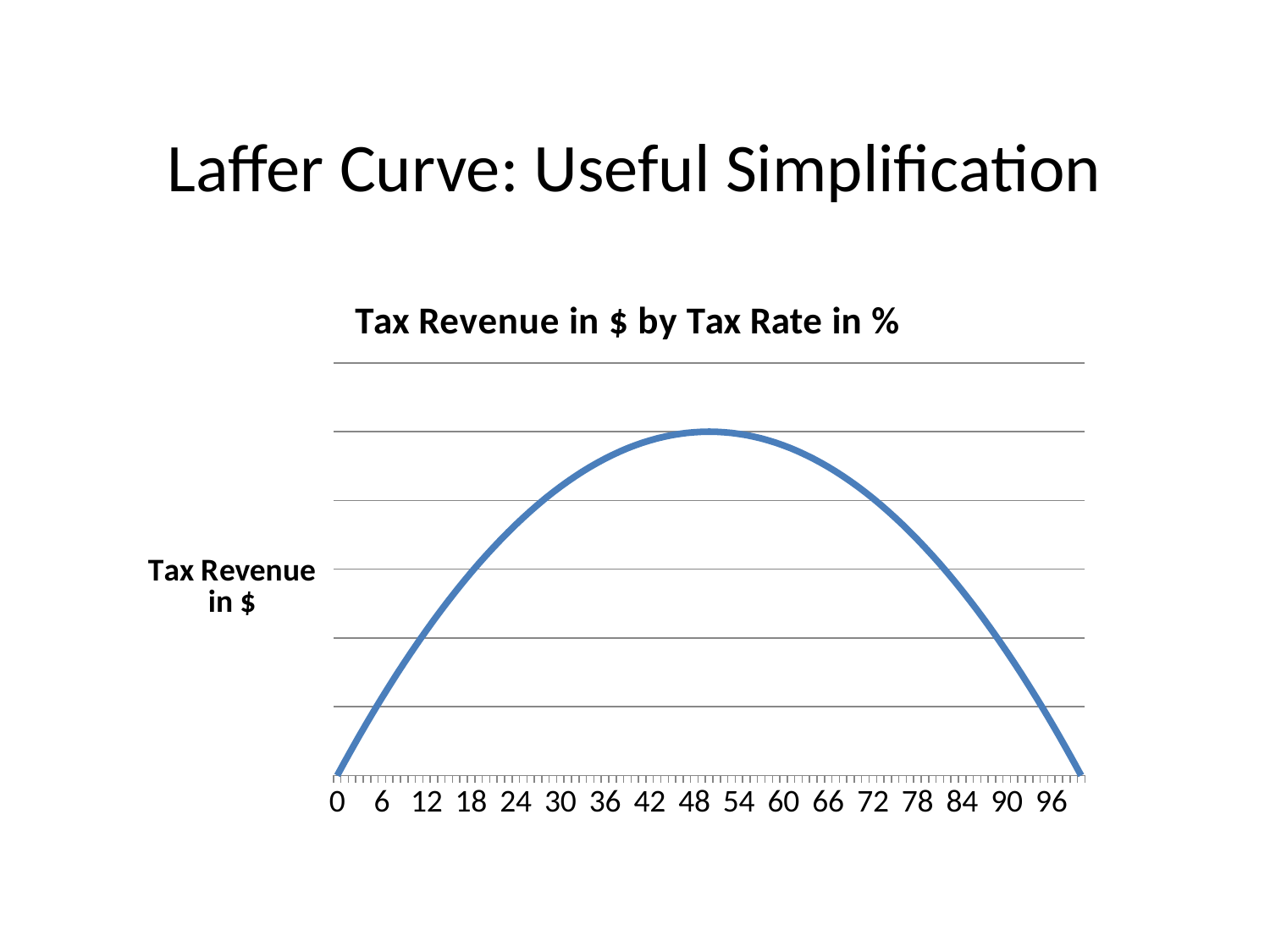
How many tick labels are printed along the x axis of the chart? 17 What is the first tick label on the x axis of the chart? 0 Which tax rate gives higher tax revenue, 12 or 48? 48 Between a tax rate of 0 and a tax rate of 48, does tax revenue rise or fall? Rise What is the title of the chart? Tax Revenue in $ by Tax Rate in % What is the last tick label printed on the x axis of the chart? 96 What kind of chart is shown on the slide? Line chart What is the label on the vertical axis of the chart? Tax Revenue in $ Which tax rate gives lower tax revenue, 0 or 30? 0 How many lines are plotted on the chart? 1 Which tax rate gives higher tax revenue, 96 or 60? 60 Between a tax rate of 54 and a tax rate of 96, does tax revenue rise or fall? Fall